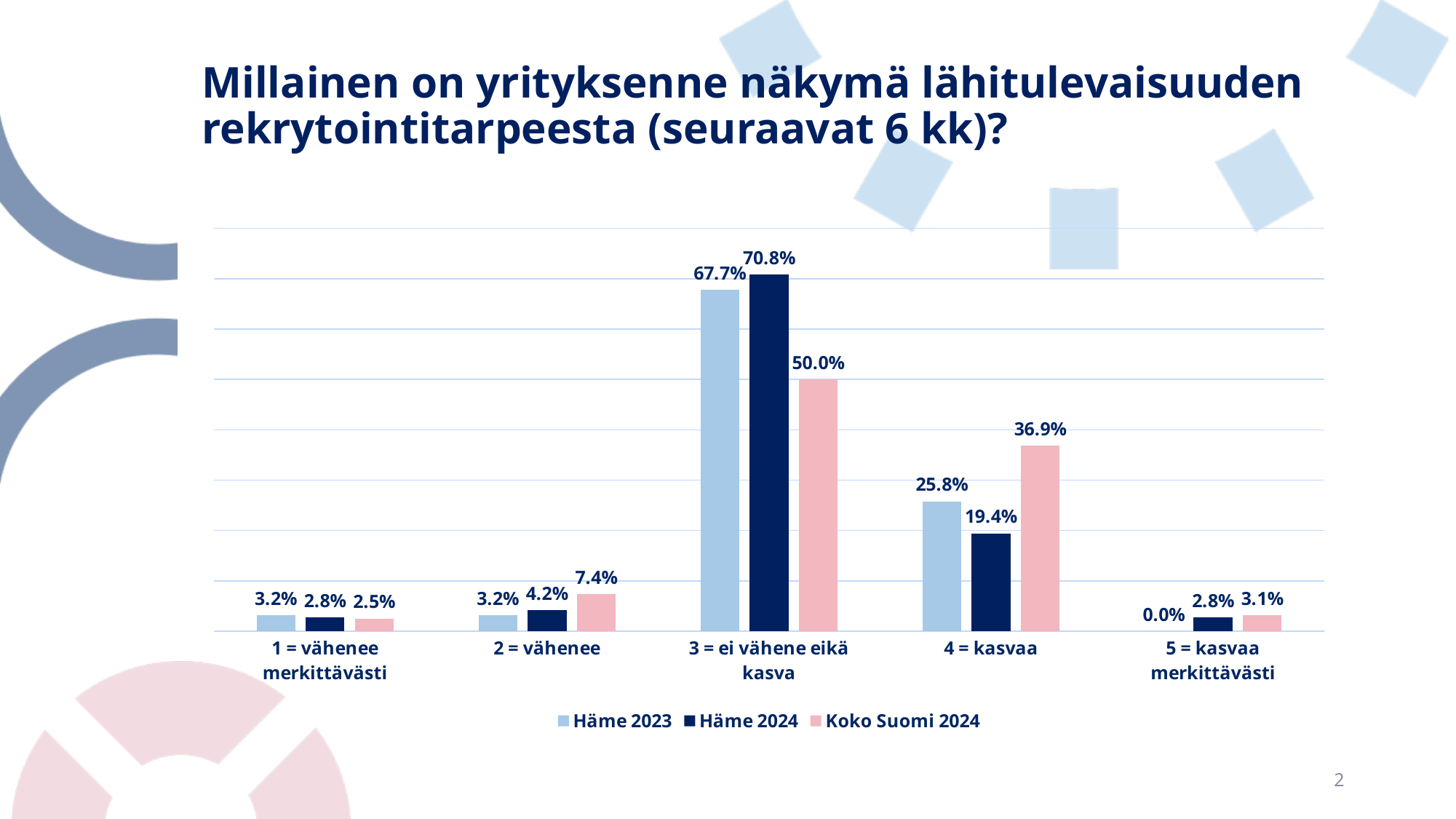
In the category '4 = kasvaa', which is larger: Häme 2023 or Häme 2024? Häme 2023 What is the difference between Koko Suomi 2024 and Häme 2024 in the category '4 = kasvaa'? 17.5% What is the difference between Häme 2024 and Häme 2023 in the category '3 = ei vähene eikä kasva'? 3.1% How many series does the legend list? 3 What is the value for Häme 2023 in the category '5 = kasvaa merkittävästi'? 0.0% Which series is shown in pink in the legend? Koko Suomi 2024 Which category has the highest value for Häme 2023? 3 = ei vähene eikä kasva What is the value for Koko Suomi 2024 in the category '4 = kasvaa'? 36.9% How many categories are shown on the x axis? 5 What kind of chart is shown on the slide? Bar chart What is the value for Häme 2024 in the category '3 = ei vähene eikä kasva'? 70.8% Which category has the lowest value for Koko Suomi 2024? 1 = vähenee merkittävästi